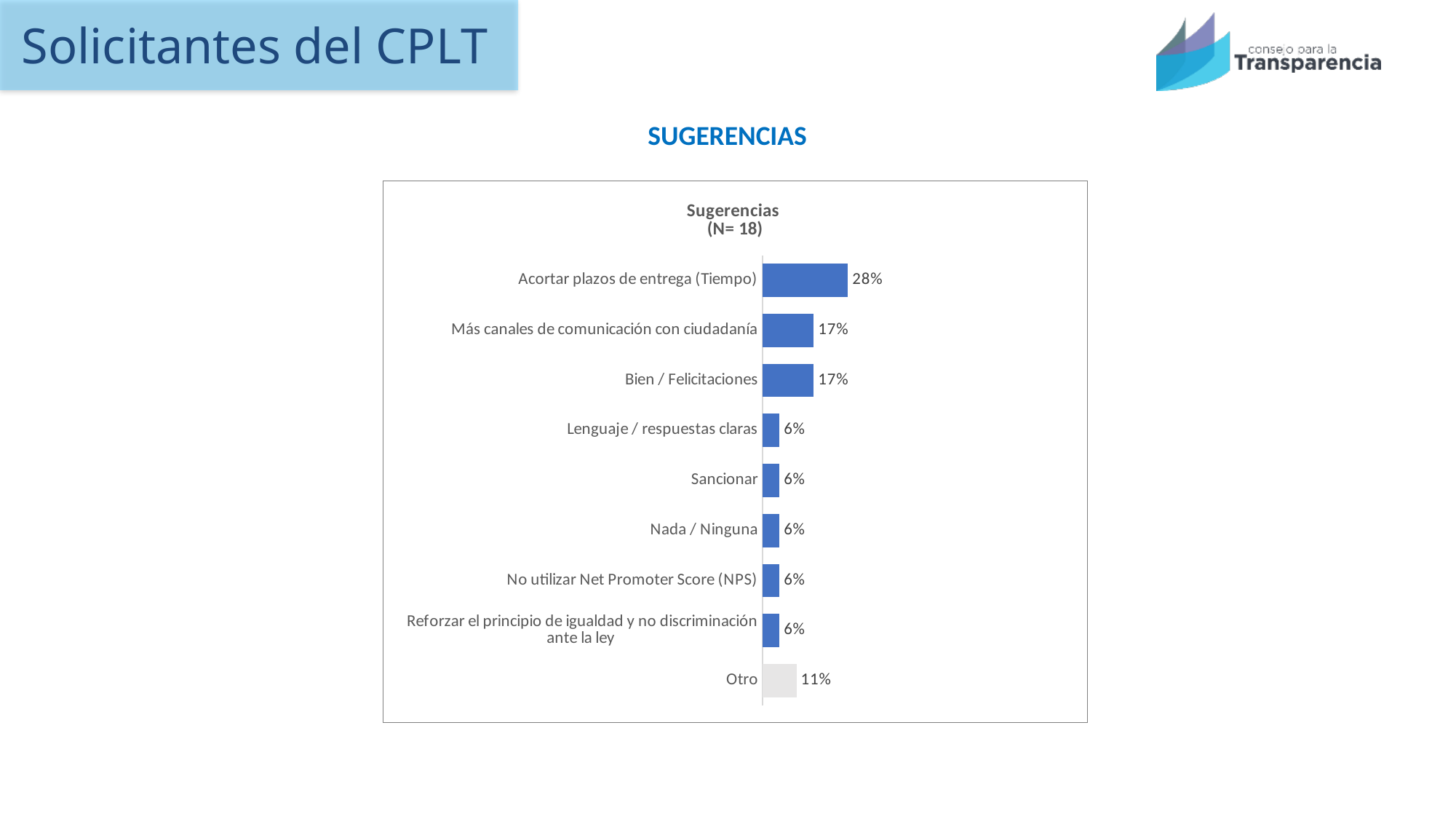
What kind of chart is shown? Bar chart Which bar is shown in grey rather than blue? Otro What is the value for "Sancionar"? 6% Which is larger, "Otro" or "Lenguaje / respuestas claras"? Otro What is the difference between "Acortar plazos de entrega (Tiempo)" and "Bien / Felicitaciones"? 11% What is the sample size (N) shown in the chart title? 18 What is the value for "Más canales de comunicación con ciudadanía"? 17% How many categories are shown in the chart? 9 What is the value for "Acortar plazos de entrega (Tiempo)"? 28% What is the difference between "Otro" and "Nada / Ninguna"? 5% Which category has the highest value? Acortar plazos de entrega (Tiempo) What is the value for "Otro"? 11%